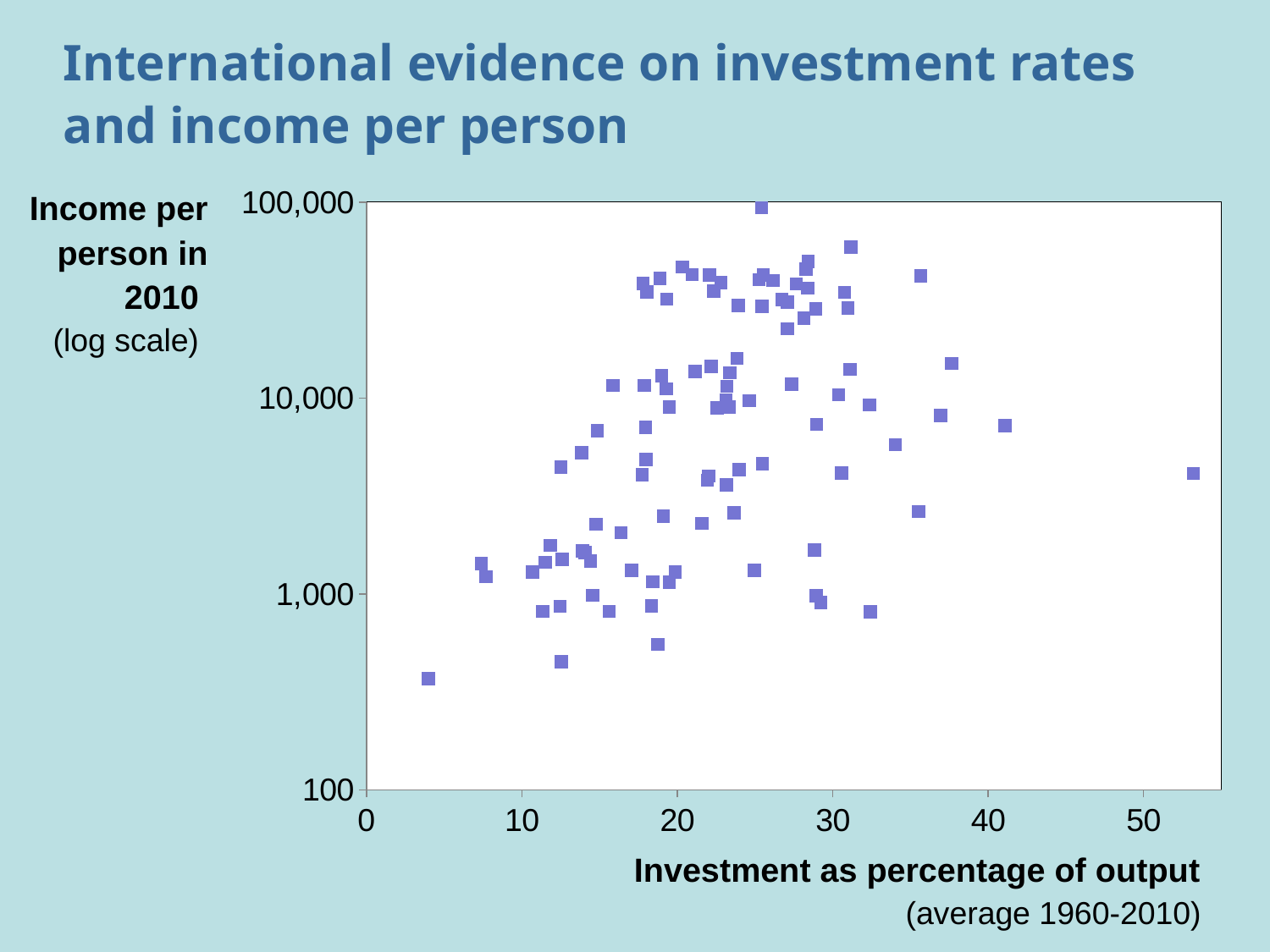
Is the income per person of the rightmost point greater or less than 10,000? less What is the title of the chart on the slide? International evidence on investment rates and income per person Is the investment rate of the lowest point on the chart greater or less than 10? less Is the investment rate of the rightmost point greater or less than 50? greater What variable is plotted on the horizontal axis of the chart? Investment as percentage of output (average 1960-2010) What kind of chart is shown on the slide? Scatter plot In general, does income per person rise or fall as investment as a percentage of output increases? Rise What is the highest value labelled on the vertical axis of the chart? 100,000